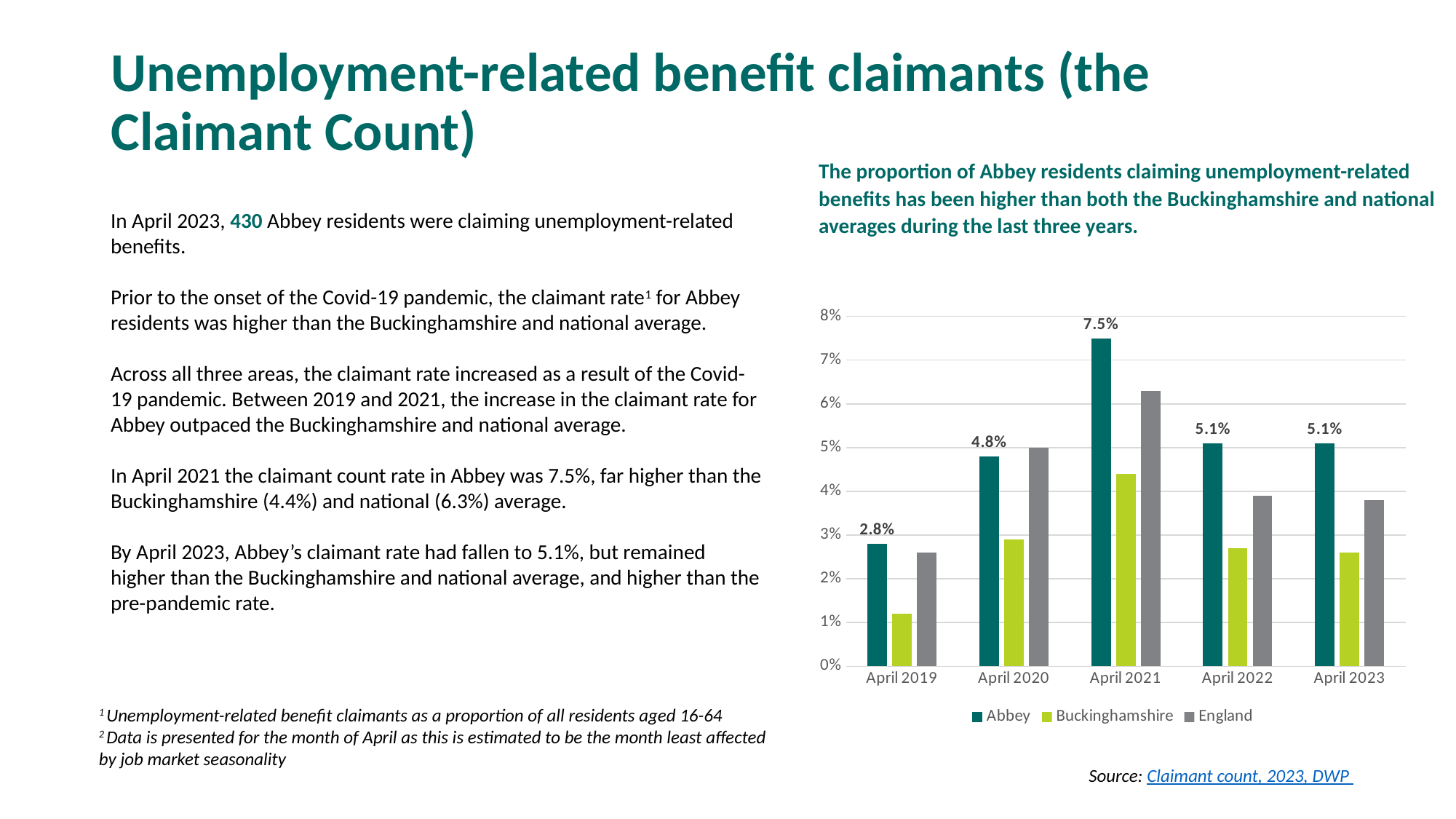
What type of chart is used on this slide? Bar chart What is the Abbey claimant rate shown for April 2023? 5.1% Is the value for Buckinghamshire in April 2019 greater or less than 2%? less In which month is the Abbey series at its lowest value? April 2019 What is the Abbey claimant rate shown for April 2021? 7.5% What is the Abbey claimant rate shown for April 2019? 2.8% In April 2021, which is larger: the Abbey bar or the England bar? Abbey In which month does the Abbey series reach its highest value? April 2021 How many series does the chart legend list? 3 By how many percentage points did the Abbey rate rise between April 2019 and April 2021? 4.7 percentage points How many time periods are shown on the x axis of the chart? 5 Is the value for England in April 2021 greater or less than 6%? greater